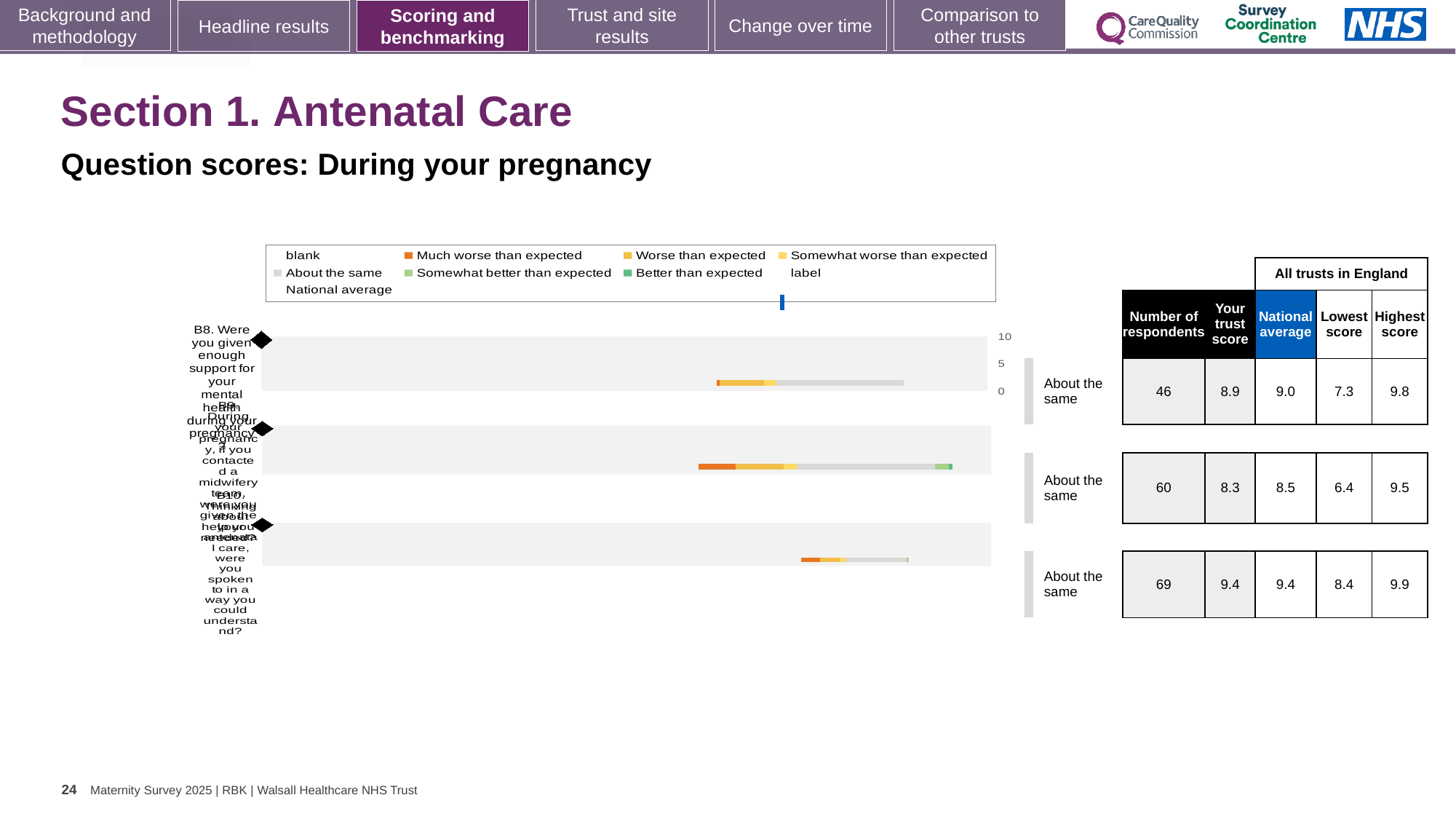
What kind of chart is shown on the slide? bar chart In the table beside the chart, what is the national average for the top row (B8)? 9.0 In the table beside the chart, what is the number of respondents for the top row (B8, support for your mental health during pregnancy)? 46 For the top row (B8), what is the difference between the highest score and the lowest score in the table? 2.5 What benchmark category is shown next to the chart for the top row (B8)? About the same What colour does the legend use for 'Better than expected'? green In the table beside the chart, what is the highest score for the bottom row? 9.9 How many question rows (bars) are plotted in the chart? 3 In the table beside the chart, what is 'Your trust score' for the top row (B8)? 8.9 Which row has the largest number of respondents in the table beside the chart? the bottom row (69) For the middle row, which is larger: 'Your trust score' or the national average? National average What colour does the legend use for 'Much worse than expected'? orange